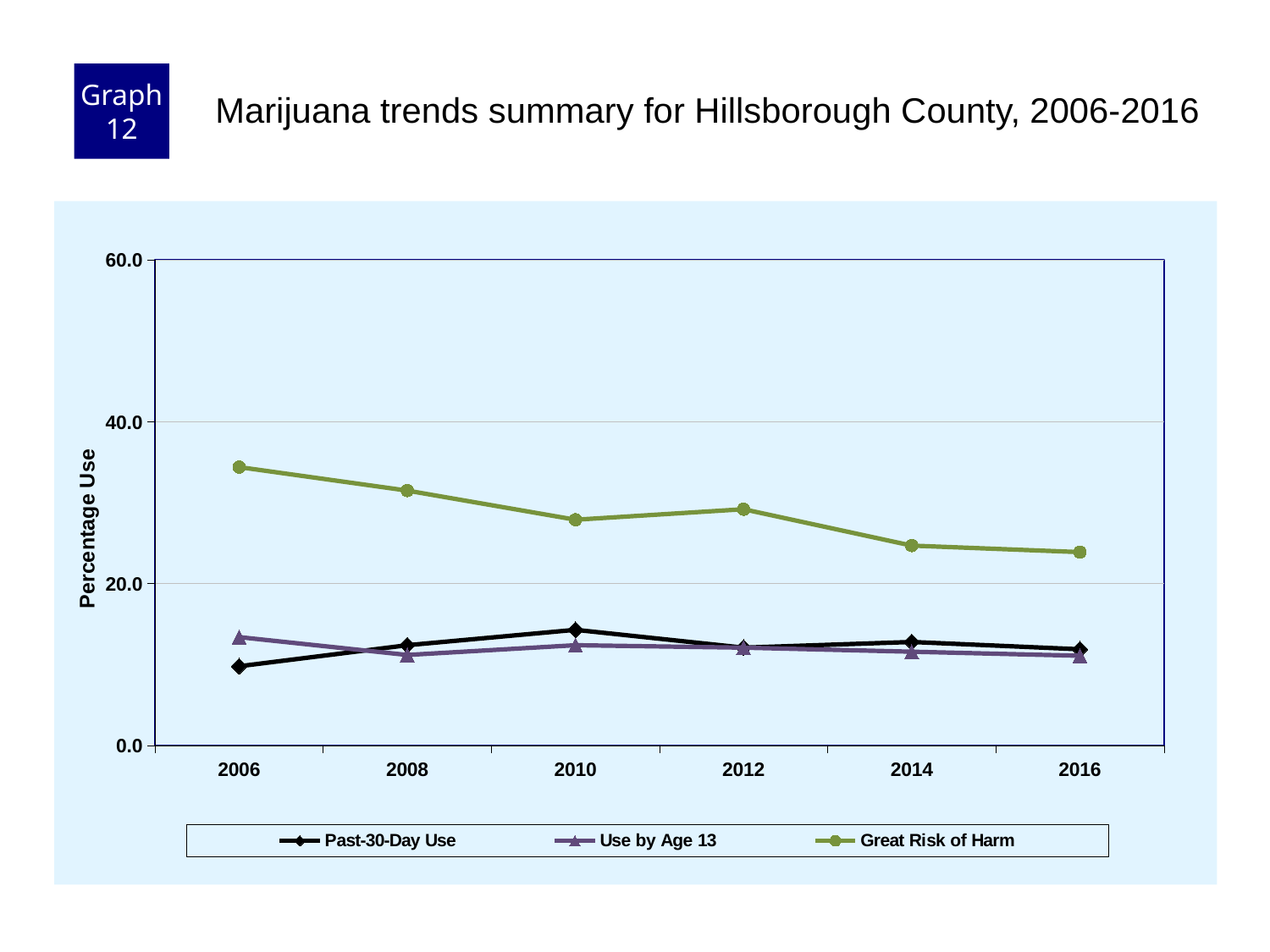
What kind of chart is shown on the slide? line chart How many years are plotted along the x axis? 6 In 2006, which is larger: Use by Age 13 or Past-30-Day Use? Use by Age 13 What is the label on the y axis? Percentage Use Is the Past-30-Day Use value for 2010 greater or less than 20.0? less In which year is the Great Risk of Harm value highest? 2006 In which year is the Past-30-Day Use value lowest? 2006 Is the Great Risk of Harm value for 2016 greater or less than 20.0? greater Is the Great Risk of Harm value for 2006 greater or less than 40.0? less How many series does the legend list? 3 Does the Great Risk of Harm line generally rise or fall from 2006 to 2016? fall In which year is the Past-30-Day Use value highest? 2010